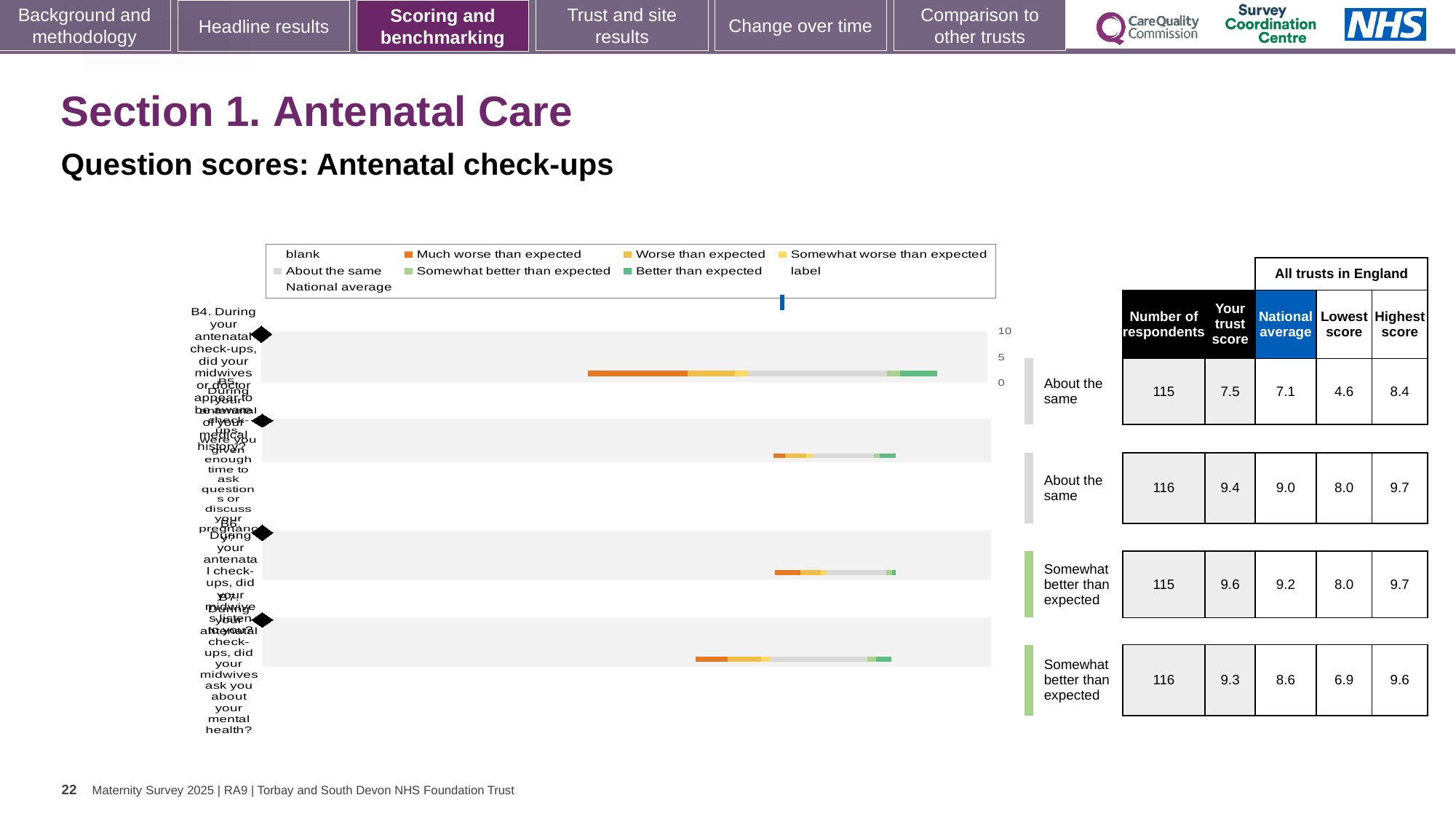
In the table beside the chart, what is the difference between 'Your trust score' and the National average for the fourth row (B7)? 0.7 In the table beside the chart, what is the Lowest score for the fourth row (B7)? 6.9 In the table beside the chart, is 'Your trust score' for the second row (B5) larger or smaller than its National average? larger What kind of chart is shown on the slide? bar chart Which colour does the legend use for 'Better than expected'? green In the table beside the chart, what is the 'Your trust score' for the first row (B4)? 7.5 In the table beside the chart, which row has the highest 'Your trust score'? third row (B6) In the table beside the chart, what is the National average for the first row (B4)? 7.1 Which colour does the legend use for 'Much worse than expected'? orange In the table beside the chart, what is the Number of respondents for the second row (B5)? 116 In the table beside the chart, which row has the lowest 'Your trust score'? first row (B4) How many question bars (rows) are plotted in the chart? 4